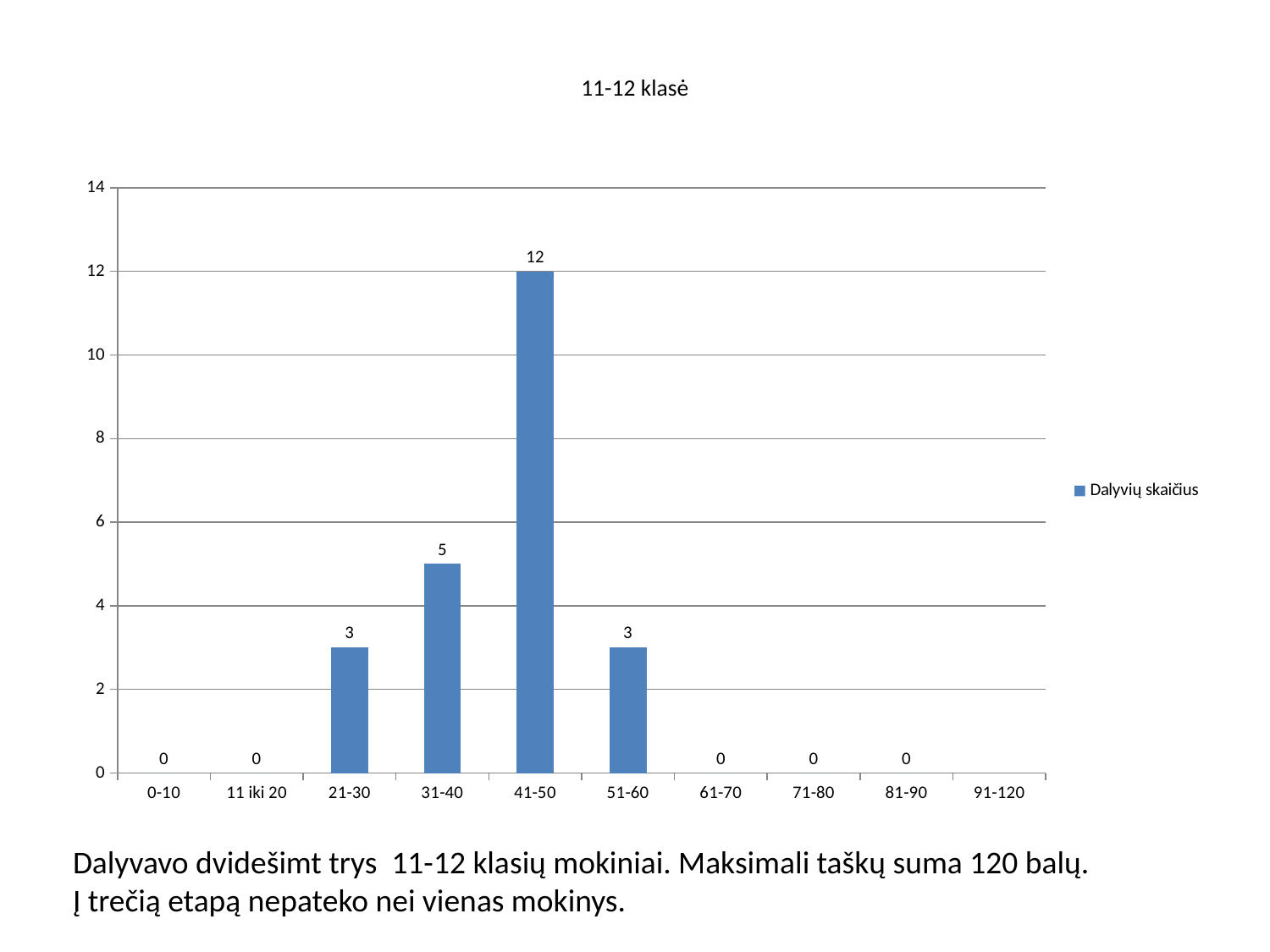
How many series does the legend list? 1 What is the value for the 41-50 category? 12 How many categories are shown on the x axis? 10 What is the value for the 21-30 category? 3 What kind of chart is shown on the slide? bar chart What is the value for the 61-70 category? 0 Which is larger, the value for 31-40 or the value for 51-60? 31-40 What is the difference between the values for 41-50 and 31-40? 7 Which category has the highest value? 41-50 Is the value for 41-50 greater or less than 10? greater What is the title of the chart? 11-12 klasė What is the value for the 31-40 category? 5